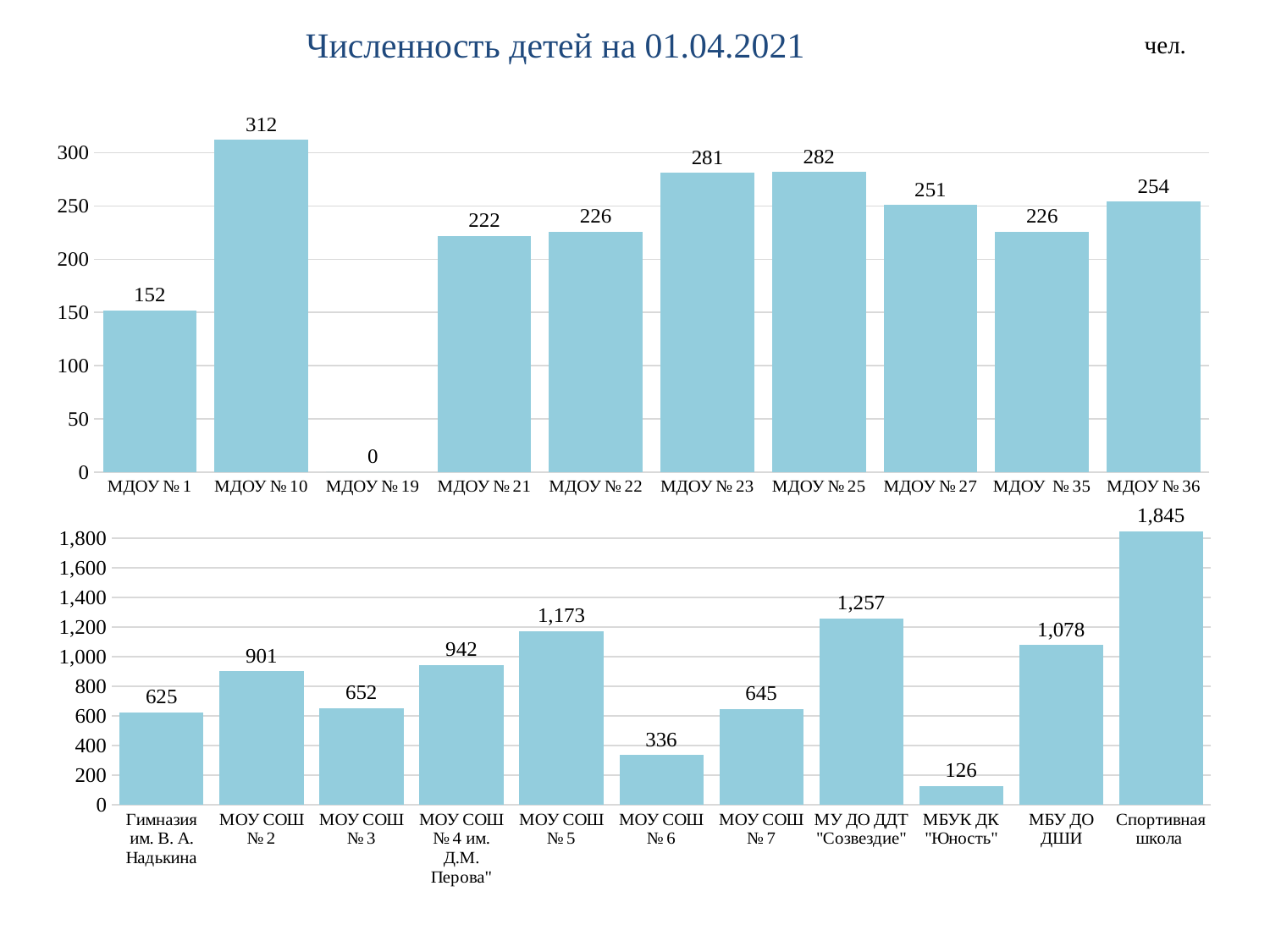
What type of chart is the bottom chart? Bar chart In the bottom chart, which category has the highest value? Спортивная школа In the top chart, what is the value for МДОУ № 10? 312 In the bottom chart, which is larger: the value for МОУ СОШ № 5 or the value for МБУ ДО ДШИ? МОУ СОШ № 5 In the bottom chart, how many categories are shown? 11 In the bottom chart, what is the value for МУ ДО ДДТ "Созвездие"? 1,257 In the top chart, what is the value for МДОУ № 27? 251 In the top chart, how many categories are shown? 10 In the bottom chart, which category has the lowest value? МБУК ДК "Юность" In the top chart, what is the difference between the values for МДОУ № 10 and МДОУ № 1? 160 In the bottom chart, what is the value for МОУ СОШ № 6? 336 In the top chart, which category has the lowest value? МДОУ № 19